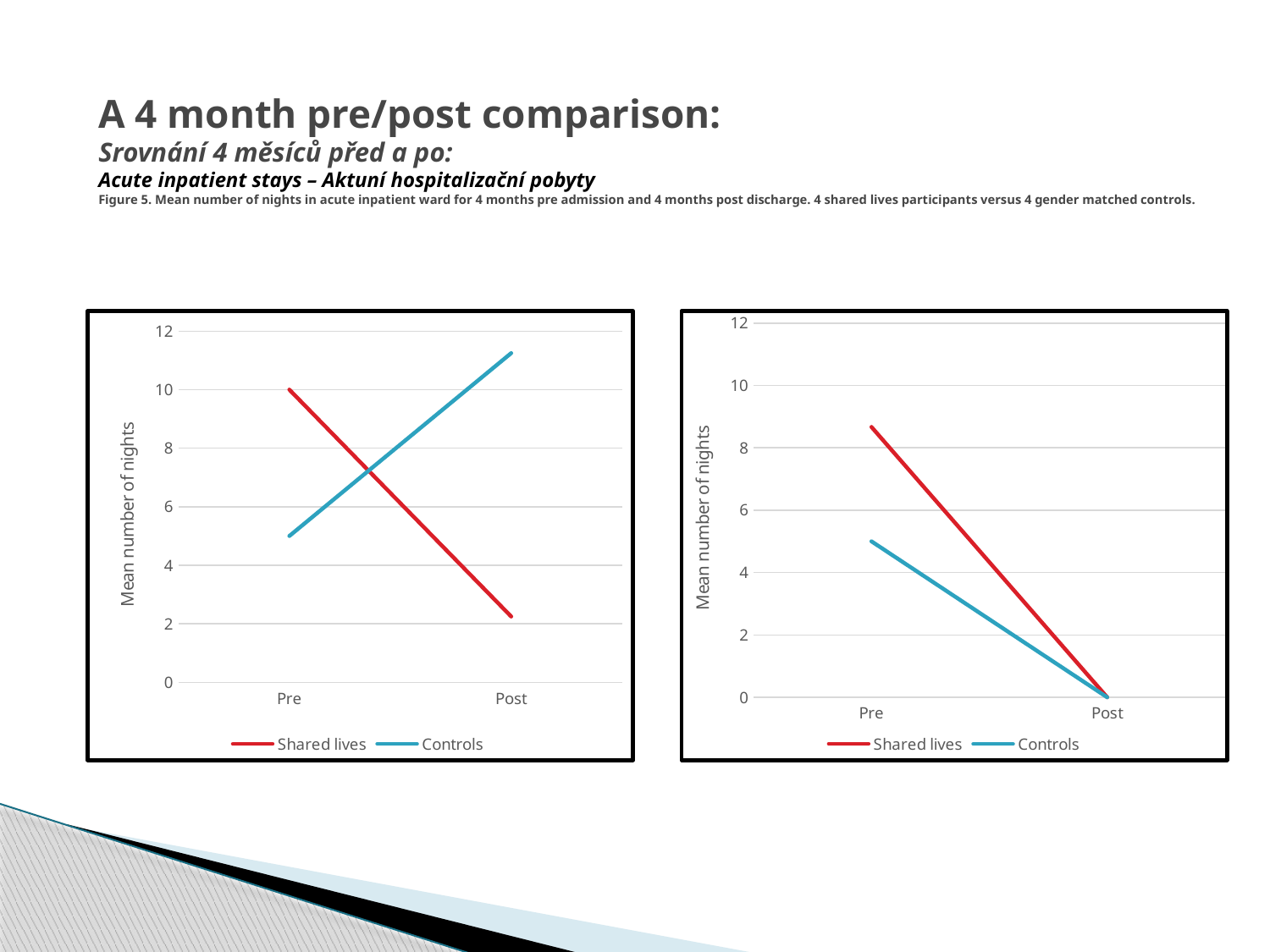
What is the y-axis label of the right chart? Mean number of nights In the left chart, is the value for Shared lives at Post greater or less than 4? less In the left chart, what is the value for Shared lives at Pre? 10 In the left chart, which series has the higher value at Post, Shared lives or Controls? Controls What type of chart is the left chart? line chart In the left chart, does the Shared lives line rise or fall from Pre to Post? fall How many series does the legend of the left chart list? 2 In the left chart, does the Controls line rise or fall from Pre to Post? rise In the right chart, is the value for Shared lives at Pre greater or less than 8? greater In the right chart, what is the value for Shared lives at Post? 0 In the left chart, is the value for Controls at Post greater or less than 10? greater In the right chart, which series has the higher value at Pre, Shared lives or Controls? Shared lives